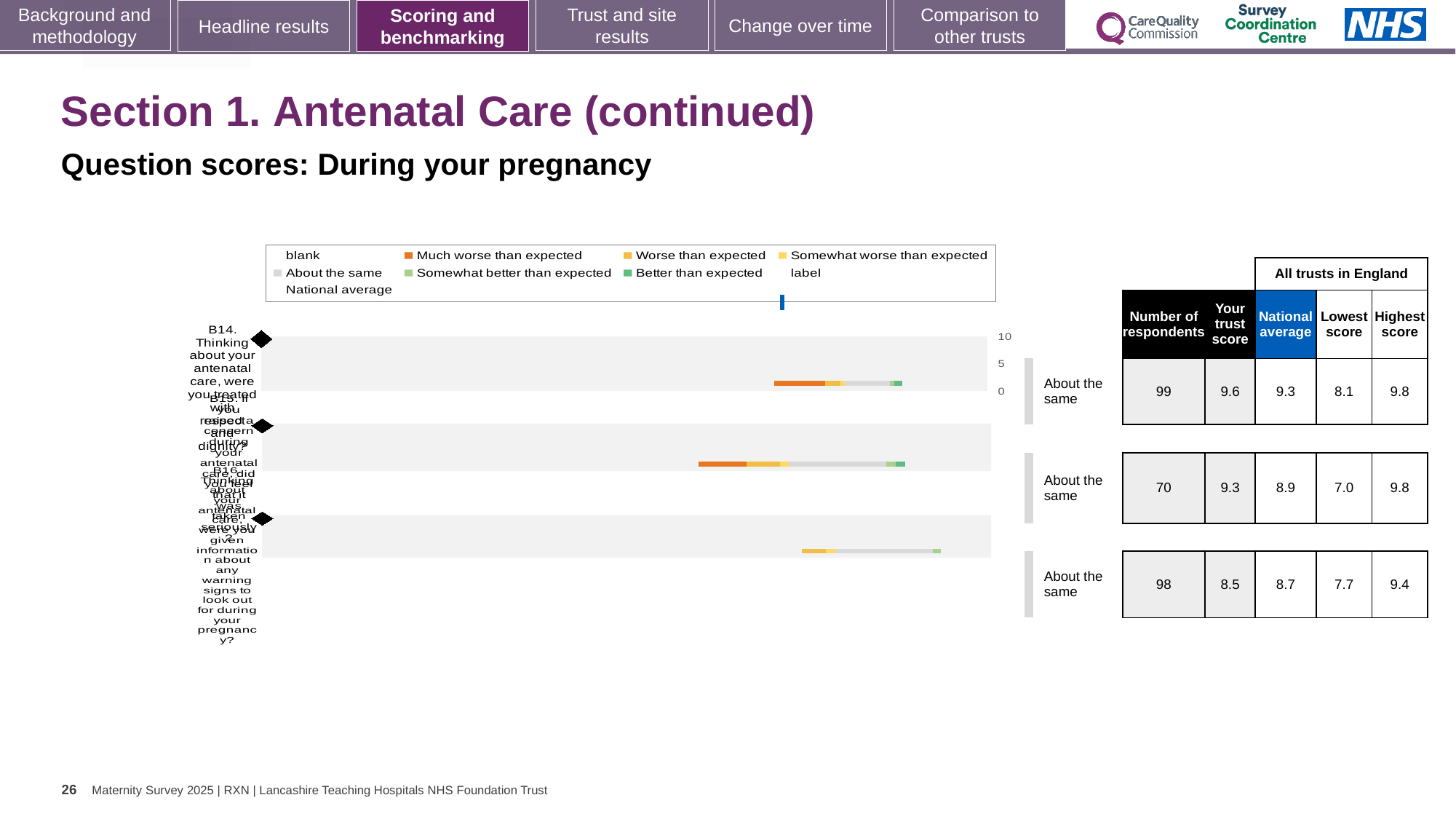
What is the difference between the trust score and the national average for the first question (B14)? 0.3 What is the number of respondents for the second question row? 70 What benchmark category is shown for all three questions? About the same What is the highest score across all trusts in England for the third question row? 9.4 Which question row has the highest number of respondents? the first row (99) How many question bars are plotted in the chart? 3 What is the national average for the first question (B14)? 9.3 Is the trust score for the third question (B16) larger or smaller than its national average? smaller What kind of chart is shown on the slide? bar chart What is the 'Your trust score' for the third question (B16, information about warning signs)? 8.5 What is the 'Your trust score' for the first question (B14, treated with respect and dignity)? 9.6 Which question row has the lowest 'Lowest score' across all trusts in England? the second row (7.0)